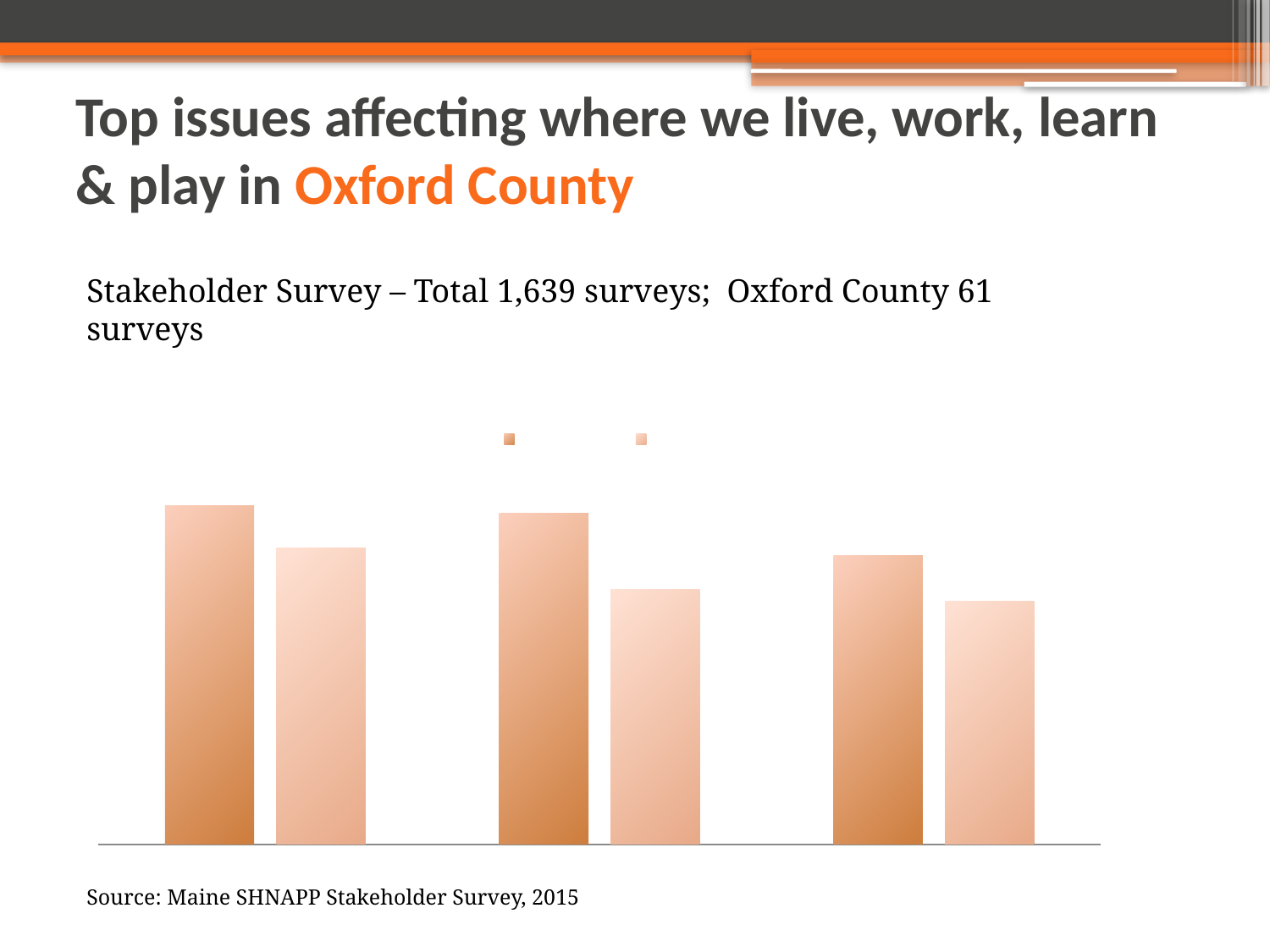
Is the lighter orange bar in the leftmost group taller or shorter than the darker orange bar in the rightmost group? taller How many bars are plotted in total on the chart? 6 Which group of bars contains the tallest bar on the chart: the leftmost, middle, or rightmost? leftmost In the rightmost group of bars, is the darker orange bar or the lighter orange bar taller? the darker orange bar What kind of chart is shown on the slide? bar chart What two colours are used for the bars on the chart? darker orange and lighter orange Which group of bars contains the shortest bar on the chart: the leftmost, middle, or rightmost? rightmost Do the lighter orange bars rise or fall from left to right across the chart? fall How many series does the chart's legend list? 2 In the leftmost group of bars, is the darker orange bar or the lighter orange bar taller? the darker orange bar Do the darker orange bars rise or fall from left to right across the chart? fall How many groups of bars does the chart show? 3